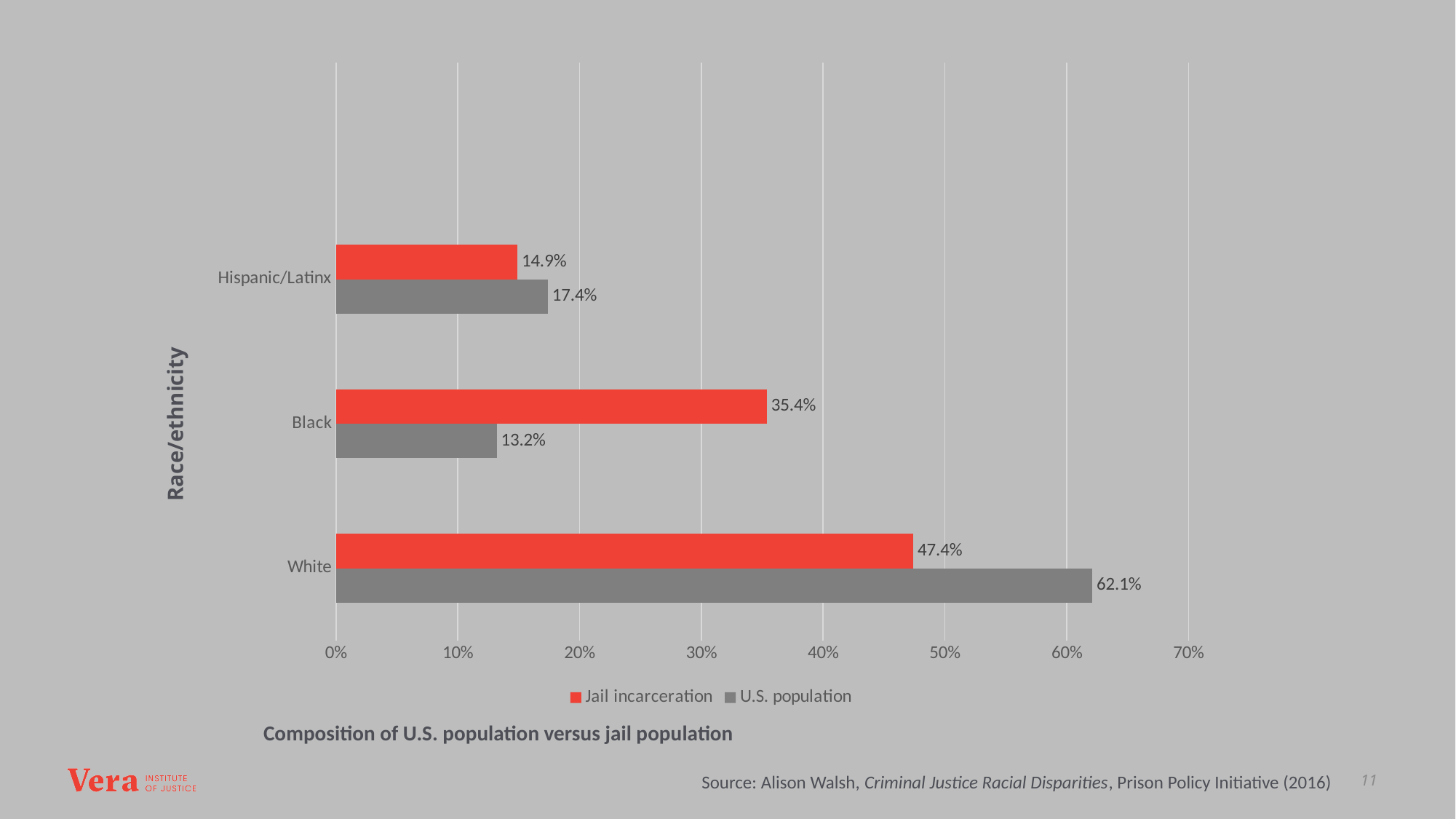
Which race/ethnicity has the highest Jail incarceration value? White What is the U.S. population value for Hispanic/Latinx? 17.4% What is the Jail incarceration value for Black? 35.4% Which is larger for Hispanic/Latinx: the Jail incarceration value or the U.S. population value? U.S. population What is the U.S. population value for White? 62.1% What type of chart is shown on the slide? Bar chart What is the difference between the Jail incarceration and U.S. population values for Black? 22.2% Which race/ethnicity has the lowest U.S. population value? Black How many race/ethnicity categories are shown on the chart? 3 How many series does the legend list? 2 What is the difference between the U.S. population and Jail incarceration values for White? 14.7% Is the Jail incarceration value for White greater or less than 40%? greater